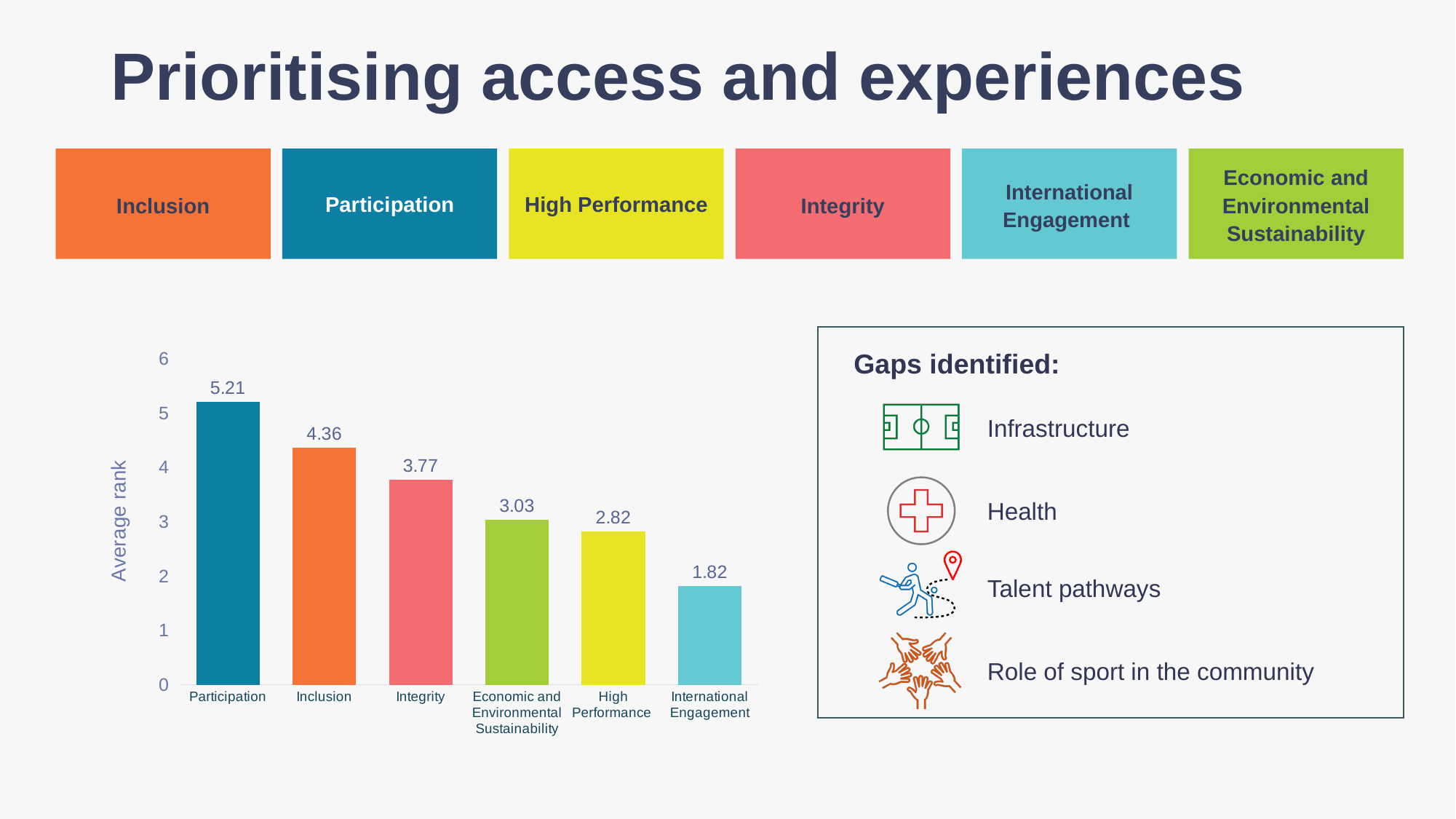
What is the label of the vertical axis of the chart? Average rank What is the average rank for Integrity? 3.77 What is the difference between the average rank for Participation and Inclusion? 0.85 Which has a higher average rank, Integrity or High Performance? Integrity What is the average rank for Participation? 5.21 What kind of chart is shown on the slide? Bar chart How many categories are shown in the bar chart? 6 What is the difference between the average rank for Economic and Environmental Sustainability and High Performance? 0.21 Is the value for Inclusion greater or less than 4? greater Which category has the highest average rank? Participation What is the average rank for International Engagement? 1.82 Which category has the lowest average rank? International Engagement